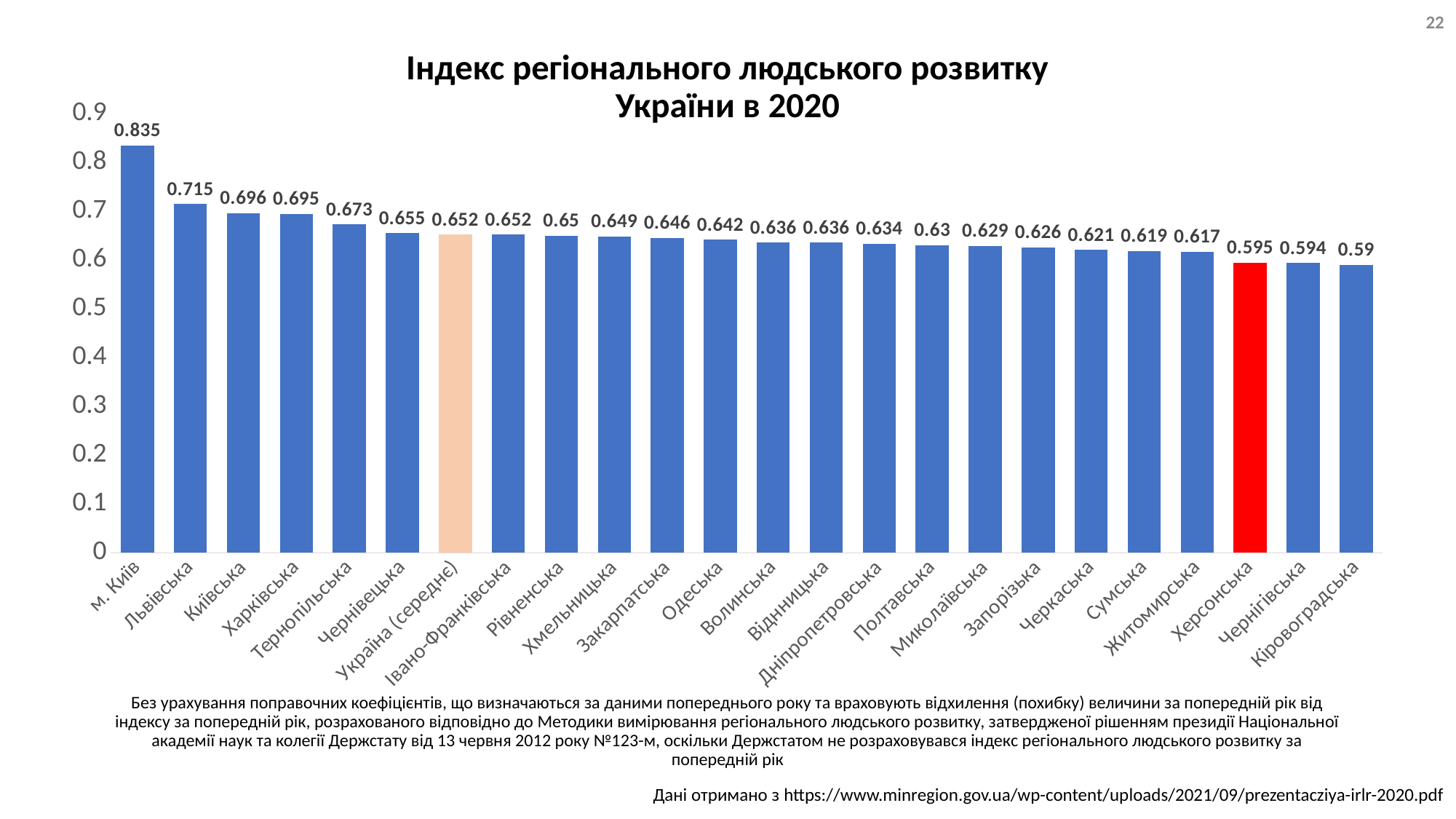
How many categories are shown on the chart? 24 What is the difference between the values for м. Київ and Львівська? 0.12 Which category has the lowest value? Кіровоградська Which bar is coloured red? Херсонська Which is larger, the value for Тернопільська or the value for Полтавська? Тернопільська What kind of chart is shown on the slide? bar chart Which category has the highest value? м. Київ What is the value for Одеська? 0.642 What is the value for Україна (середнє)? 0.652 Is the value for Львівська greater or less than 0.7? greater What is the value for м. Київ? 0.835 What is the value for Херсонська? 0.595